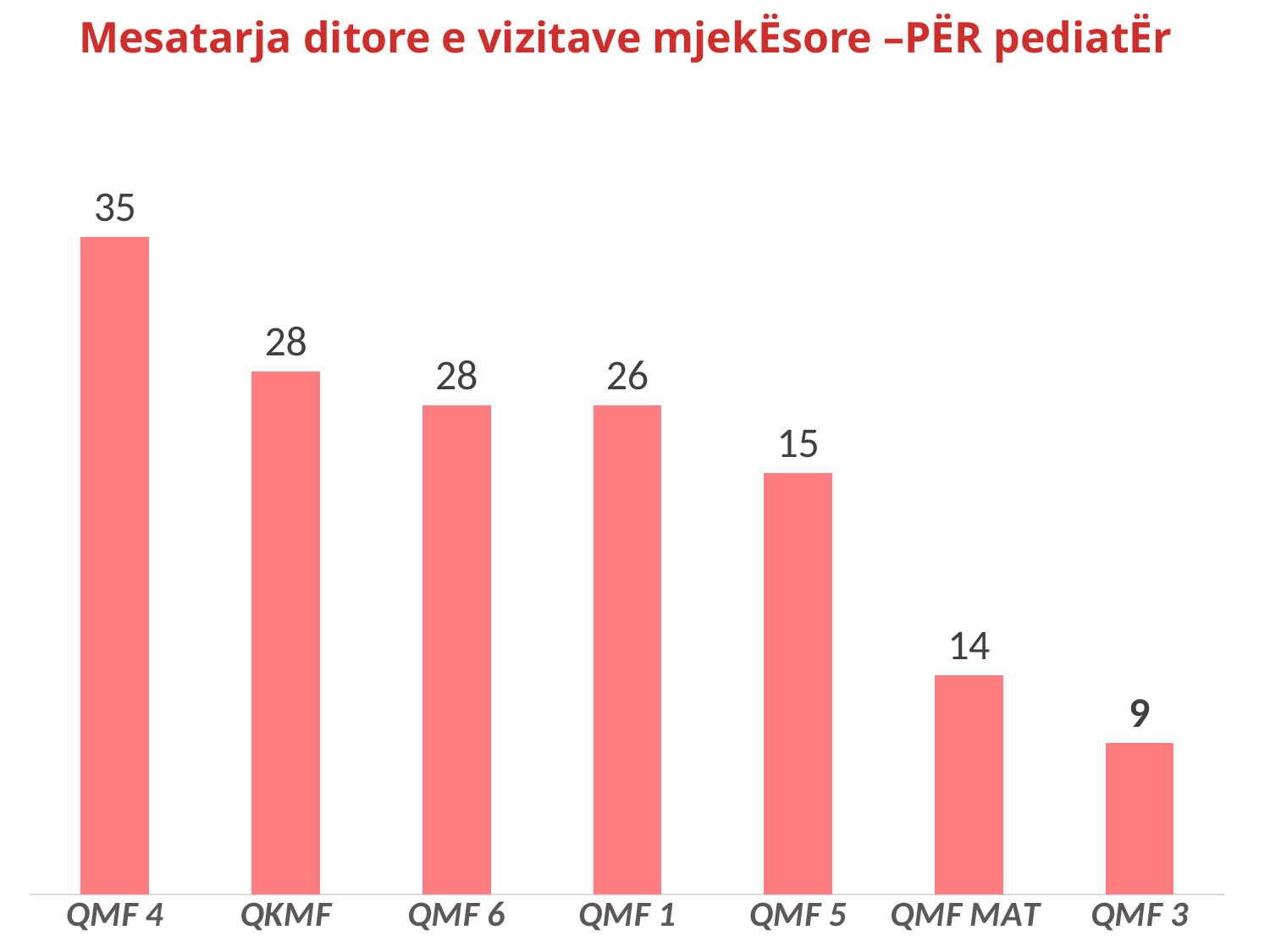
What is the value for QMF 4? 35 Which is larger, the value for QMF 5 or the value for QMF MAT? QMF 5 What is the value for QMF MAT? 14 Which category has the lowest value? QMF 3 How many categories are shown on the chart? 7 What kind of chart is shown on the slide? Bar chart What is the difference between the values for QKMF and QMF 1? 2 What is the value for QMF 1? 26 What is the difference between the values for QMF 4 and QMF 5? 20 Do the values rise or fall from left to right along the x axis? Fall What is the value for QMF 3? 9 Which category has the highest value? QMF 4